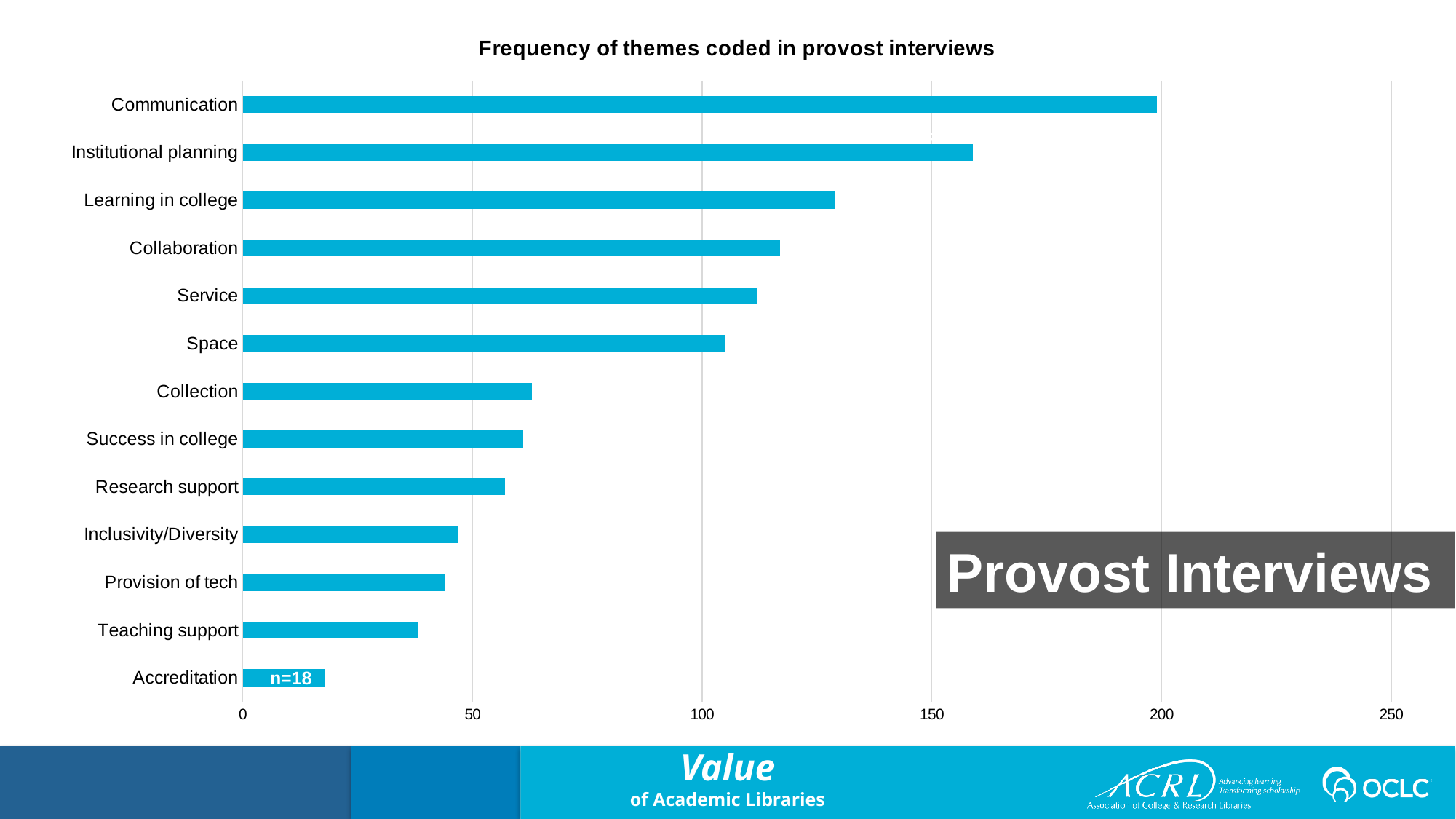
Is the value for Space greater or less than 100? greater What kind of chart is shown on the slide? bar chart Which theme has the highest frequency? Communication Is the value for Communication greater or less than 150? greater Which has a higher frequency, Research support or Inclusivity/Diversity? Research support Is the value for Collection greater or less than 100? less Which has a higher frequency, Learning in college or Service? Learning in college What is the title of the chart? Frequency of themes coded in provost interviews How many themes (categories) are plotted in the chart? 13 Which theme has the lowest frequency? Accreditation